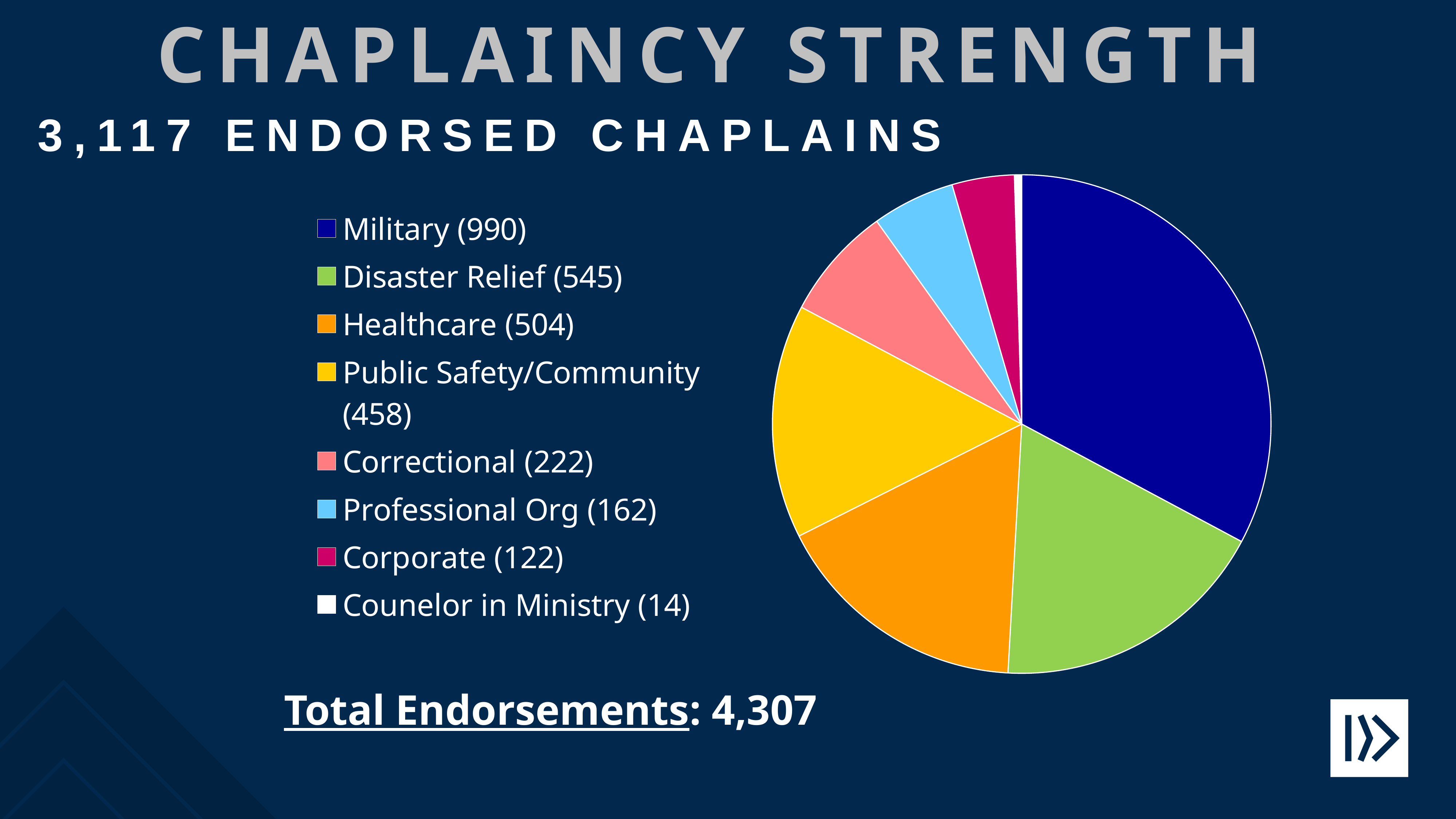
What kind of chart is shown on the slide? pie chart Which category has the largest slice of the pie chart? Military What is the difference between the Correctional value and the Professional Org value? 60 What is the difference between the Military value and the Disaster Relief value? 445 What colour is the Public Safety/Community slice in the pie chart? yellow What is the value for Military in the pie chart? 990 What is the value for Healthcare in the pie chart? 504 Which is larger, the value for Disaster Relief or the value for Healthcare? Disaster Relief Which category has the smallest slice of the pie chart? Counelor in Ministry How many categories does the pie chart show? 8 What is the value for Public Safety/Community in the pie chart? 458 What is the value for Corporate in the pie chart? 122